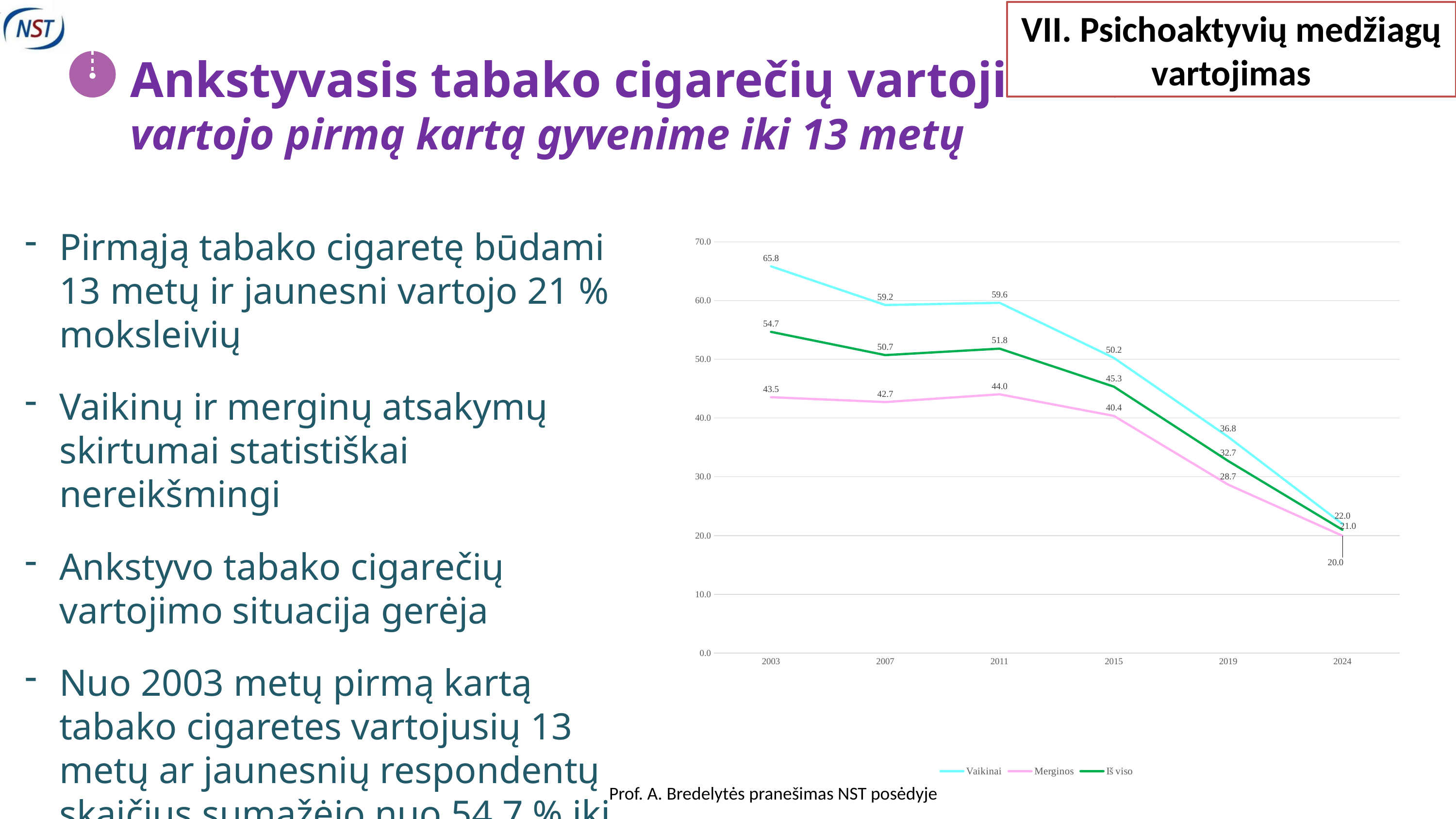
How many years are plotted along the x axis of the chart? 6 Overall, do the Iš viso values rise or fall from 2003 to 2024? fall What is the value for Merginos in 2011? 44.0 What kind of chart is shown on the slide? line chart Which series has the larger value in 2007, Vaikinai or Iš viso? Vaikinai What is the value for Vaikinai in 2003? 65.8 In which year is the Merginos value lowest? 2024 What is the value for Vaikinai in 2024? 22.0 What is the difference between the Vaikinai and Merginos values in 2015? 9.8 How many series does the chart legend list? 3 What is the value for Iš viso in 2019? 32.7 In which year is the Vaikinai value highest? 2003